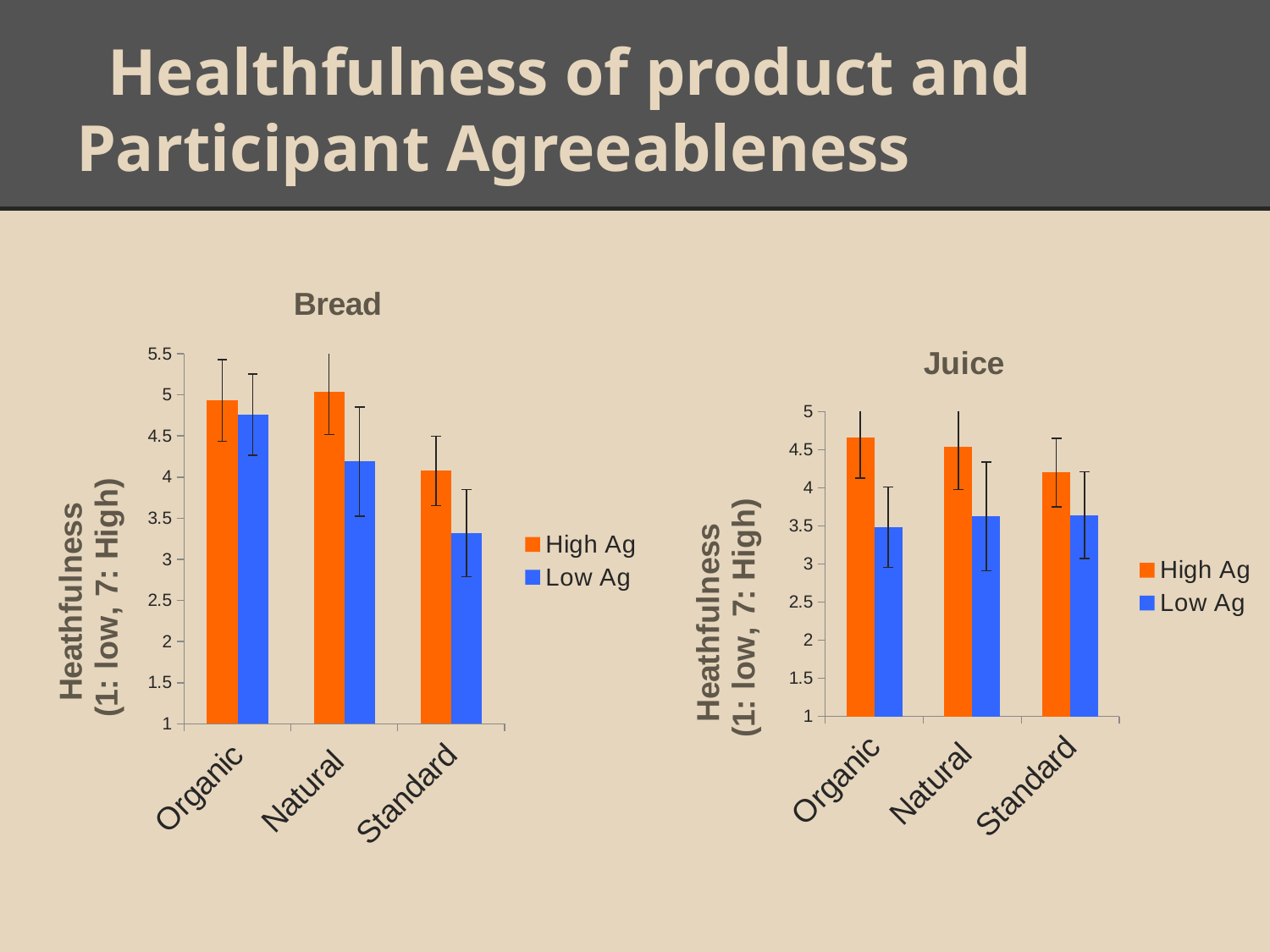
In the Bread chart, is the Low Ag value for Standard greater or less than 3.5? less In the Juice chart, how many series does the legend list? 2 In the Bread chart, how many product categories are shown on the x axis? 3 In the Bread chart, is the High Ag value for Natural greater or less than 4.5? greater In the Juice chart, is the Low Ag value for Organic greater or less than 4? less In the Juice chart, what colour are the High Ag bars? orange In the Juice chart, which category has the highest High Ag value? Organic In the Bread chart, what kind of chart is shown? bar chart In the Bread chart, which category has the lowest Low Ag value? Standard In the Bread chart, do the Low Ag values rise or fall from Organic to Standard? fall In the Juice chart, which is larger for Natural: the High Ag value or the Low Ag value? High Ag